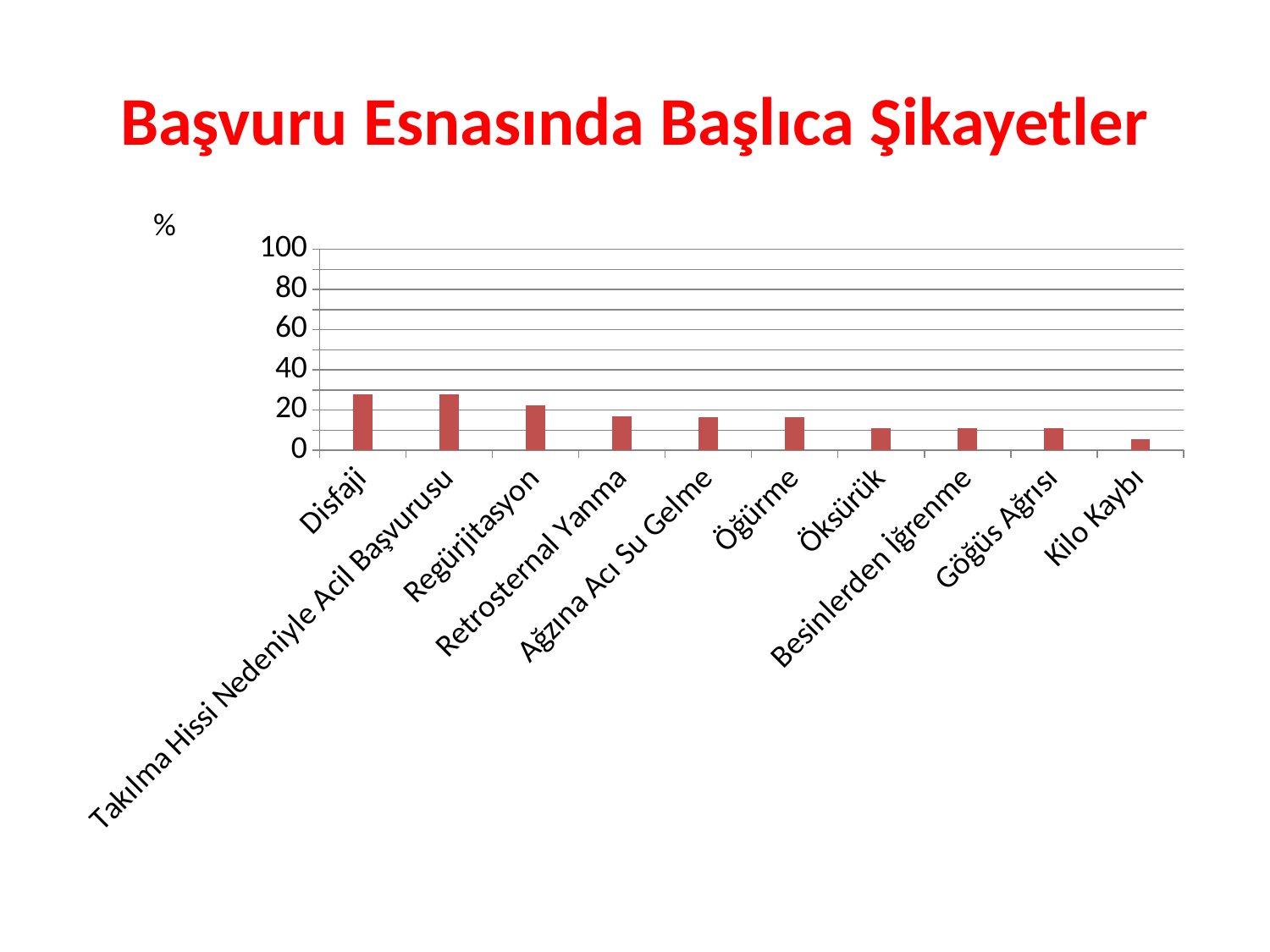
Is the value for Öksürük greater or less than 20? less What kind of chart is shown on the slide? bar chart Is the value for Kilo Kaybı greater or less than 20? less Which category has the lowest value in the chart? Kilo Kaybı Which is larger, the value for Disfaji or the value for Kilo Kaybı? Disfaji How many categories are plotted in the chart? 10 Do the values generally rise or fall from left to right along the x axis? fall Which is larger, the value for Regürjitasyon or the value for Öksürük? Regürjitasyon What unit is indicated for the vertical axis of the chart? % Is the value for Disfaji greater or less than 20? greater What is the title of the chart on the slide? Başvuru Esnasında Başlıca Şikayetler